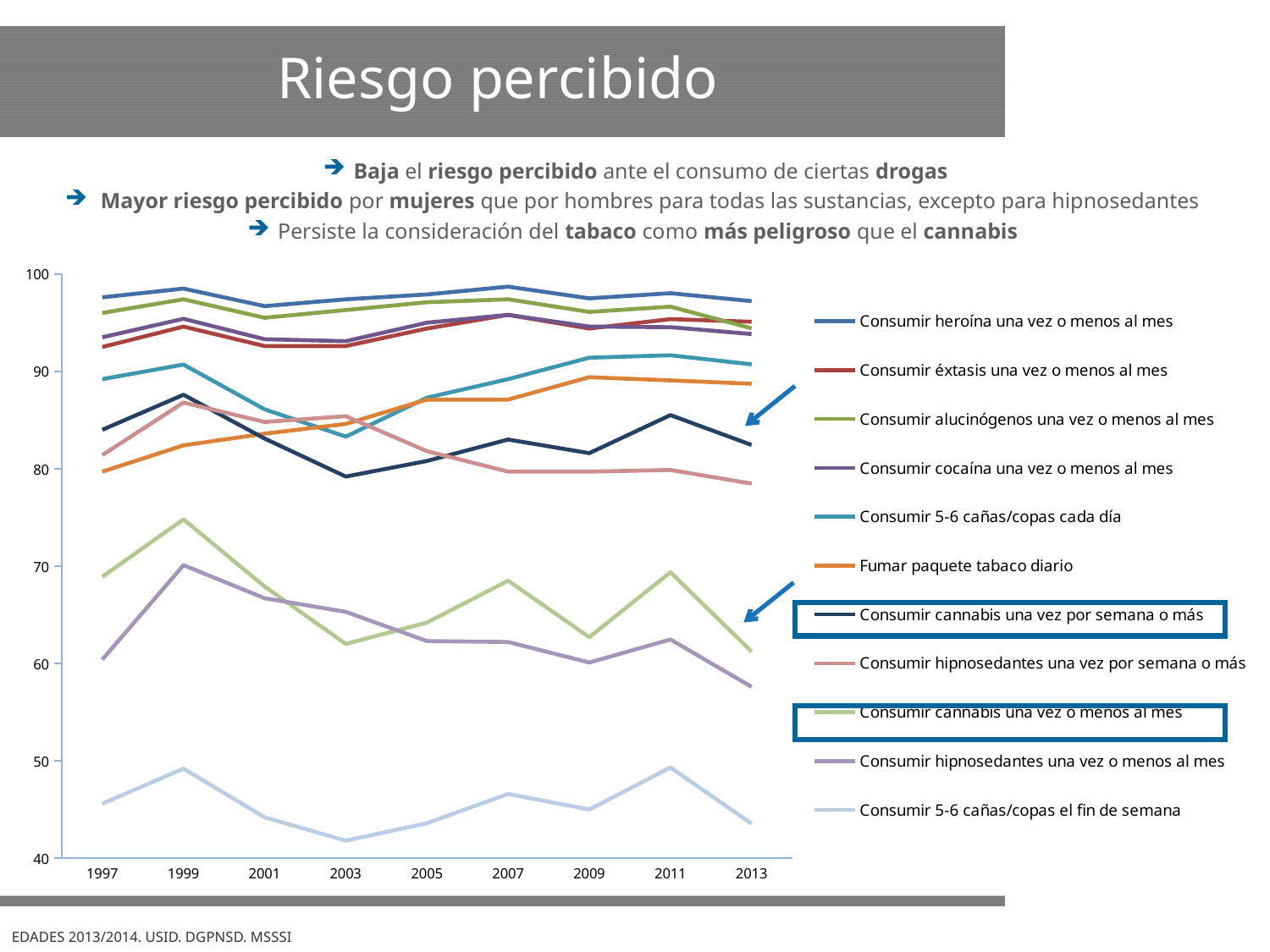
What kind of chart is shown on the slide? line chart Does the series 'Consumir hipnosedantes una vez por semana o más' rise or fall from 1999 to 2013? fall In 2013, which is higher: 'Fumar paquete tabaco diario' or 'Consumir cannabis una vez por semana o más'? Fumar paquete tabaco diario Is the 2013 value for 'Consumir 5-6 cañas/copas el fin de semana' greater or less than 50? less How many series does the chart legend list? 11 Is the 2013 value for 'Consumir cannabis una vez o menos al mes' greater or less than 70? less What is the first year shown on the x axis of the chart? 1997 Is the 2013 value for 'Fumar paquete tabaco diario' greater or less than 80? greater How many years are plotted along the x axis of the chart? 9 Which series has the lowest values across the chart? Consumir 5-6 cañas/copas el fin de semana Which series has the highest values across the chart? Consumir heroína una vez o menos al mes